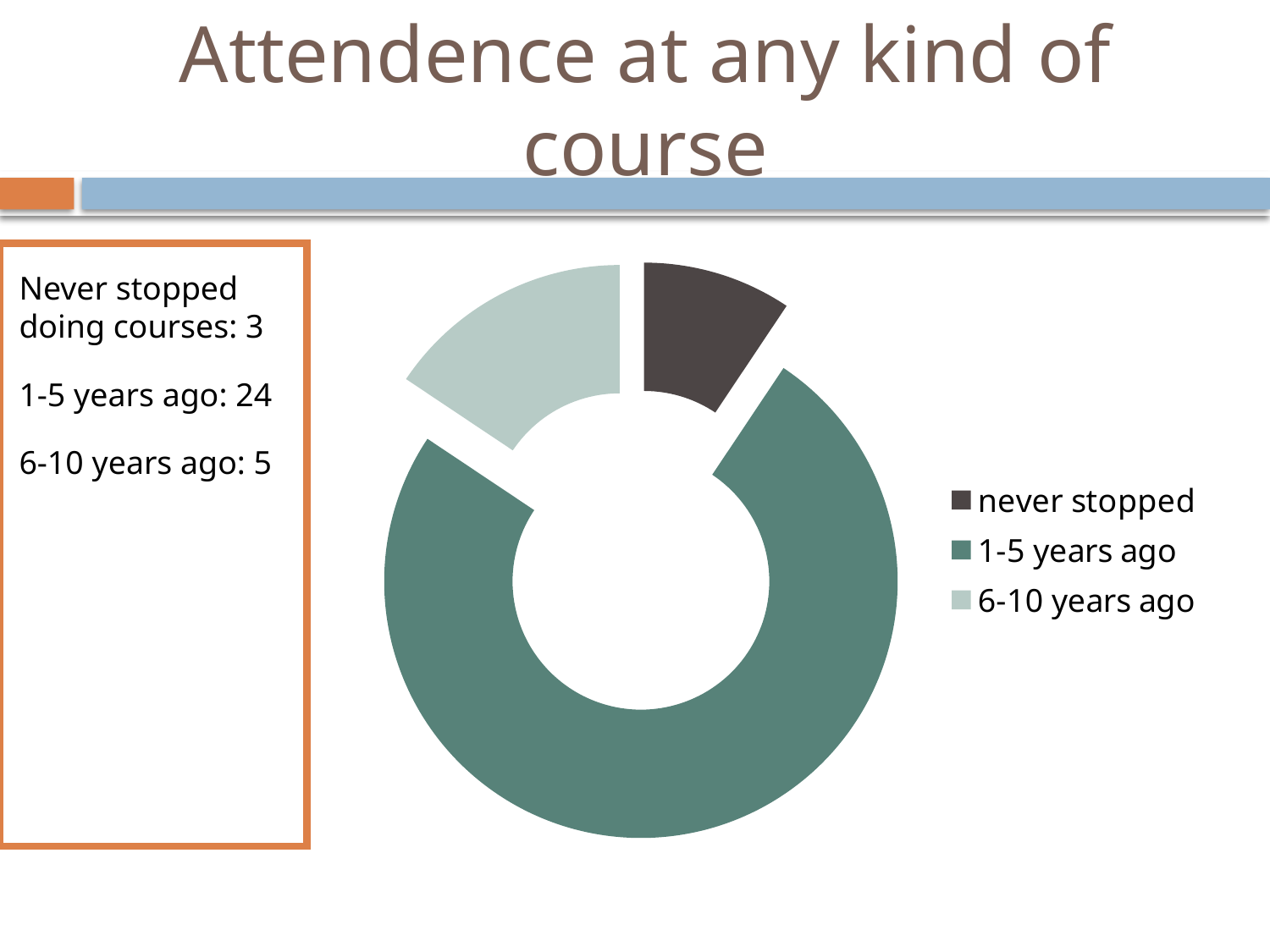
How many categories does the doughnut chart show? 3 Which category has the smallest share of the doughnut chart? never stopped What is the difference between the values for '1-5 years ago' and '6-10 years ago'? 19 Which category has the largest share of the doughnut chart? 1-5 years ago What is the title of the slide containing the chart? Attendence at any kind of course What share of the total does '1-5 years ago' represent? 75% What is the value for '6-10 years ago'? 5 Which is larger, the value for '6-10 years ago' or the value for 'never stopped'? 6-10 years ago What is the value for '1-5 years ago'? 24 How many entries does the legend list? 3 What is the value for 'never stopped'? 3 What kind of chart is shown on the slide? Doughnut chart